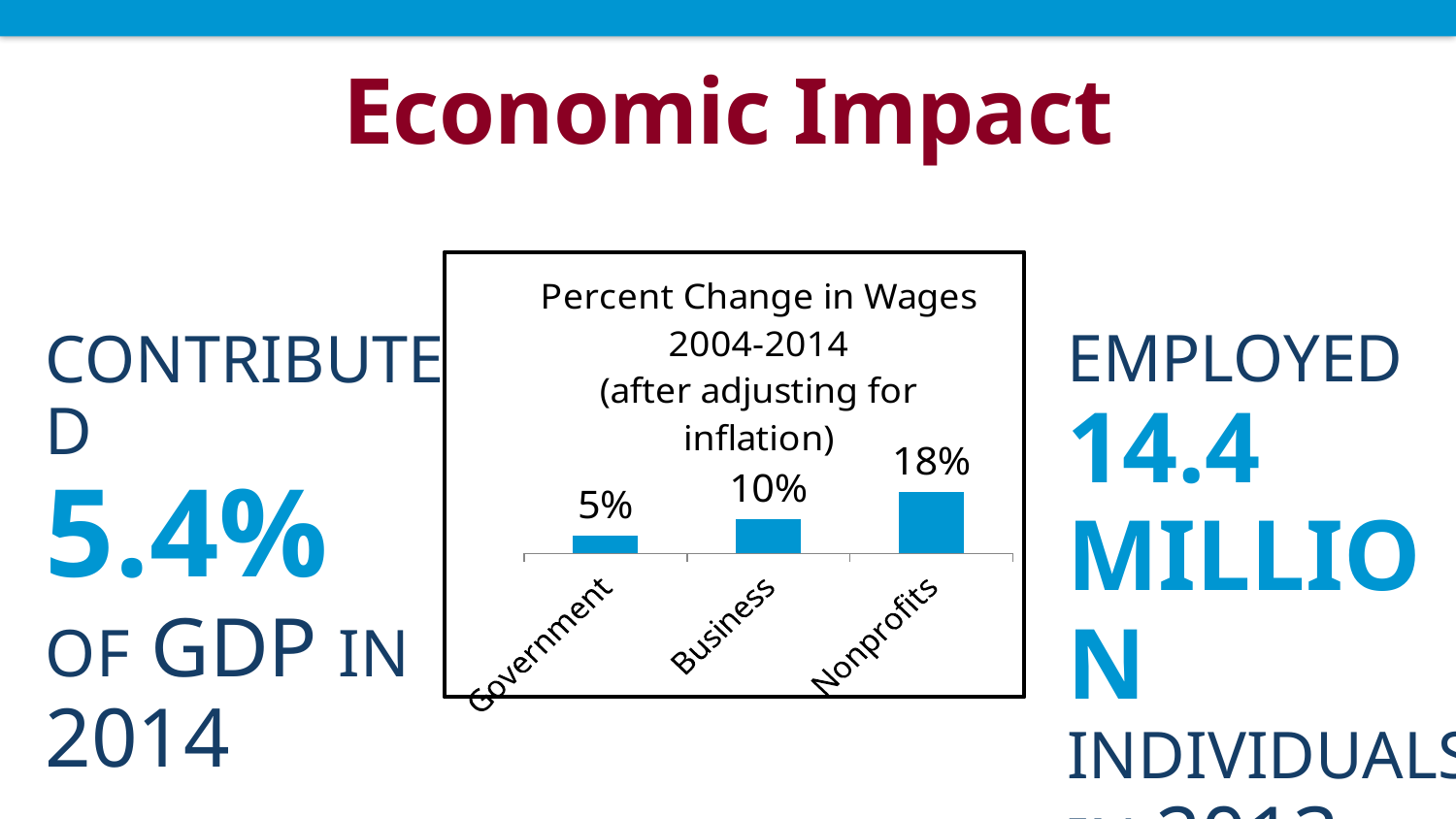
What is the percent change in wages for Nonprofits? 18% What time period does the chart title say the percent change in wages covers? 2004-2014 Which sector has the lowest percent change in wages? Government What kind of chart is shown on the slide? Bar chart What is the percent change in wages for Government? 5% Do the values rise or fall from Government to Nonprofits along the x axis? Rise What is the difference between the percent change in wages for Business and Government? 5% What is the percent change in wages for Business? 10% What is the difference between the percent change in wages for Nonprofits and Government? 13% How many sectors are shown in the chart? 3 Which sector has the highest percent change in wages? Nonprofits Which has a larger percent change in wages, Business or Nonprofits? Nonprofits